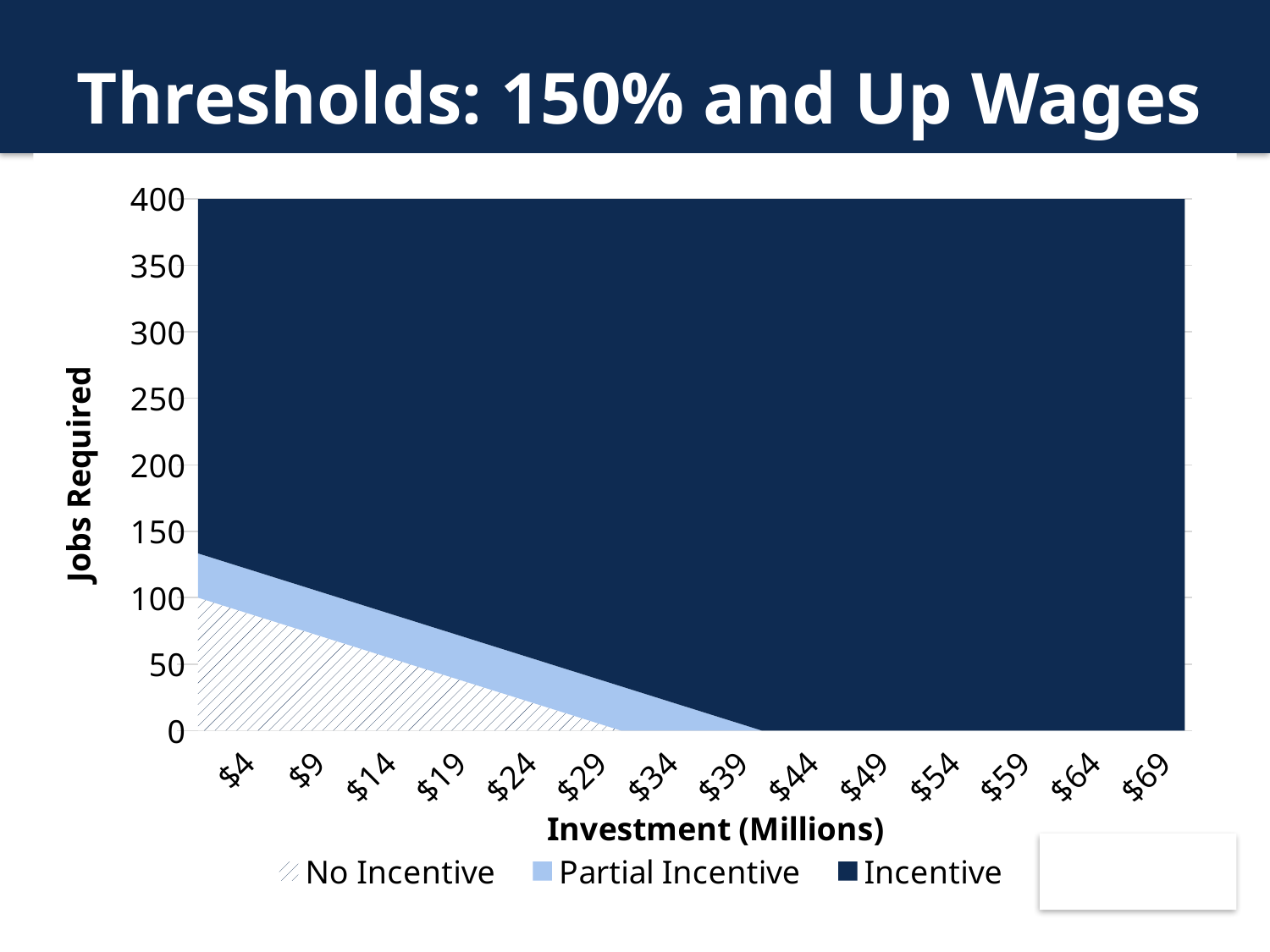
How many series does the legend list? 3 Does the No Incentive area rise or fall as investment increases along the x axis? Fall What is the highest investment value shown on the x axis? $69 What kind of chart is shown on the slide? Area chart Which series is drawn with a hatched pattern? No Incentive How many investment categories are shown on the x axis? 14 Is the No Incentive value at $24 greater or less than 100? less Which series covers the largest area of the chart? Incentive Is the top of the Partial Incentive band at $4 greater or less than 150? less Is the No Incentive value at $4 greater or less than 50? greater What is the title of the slide containing the chart? Thresholds: 150% and Up Wages